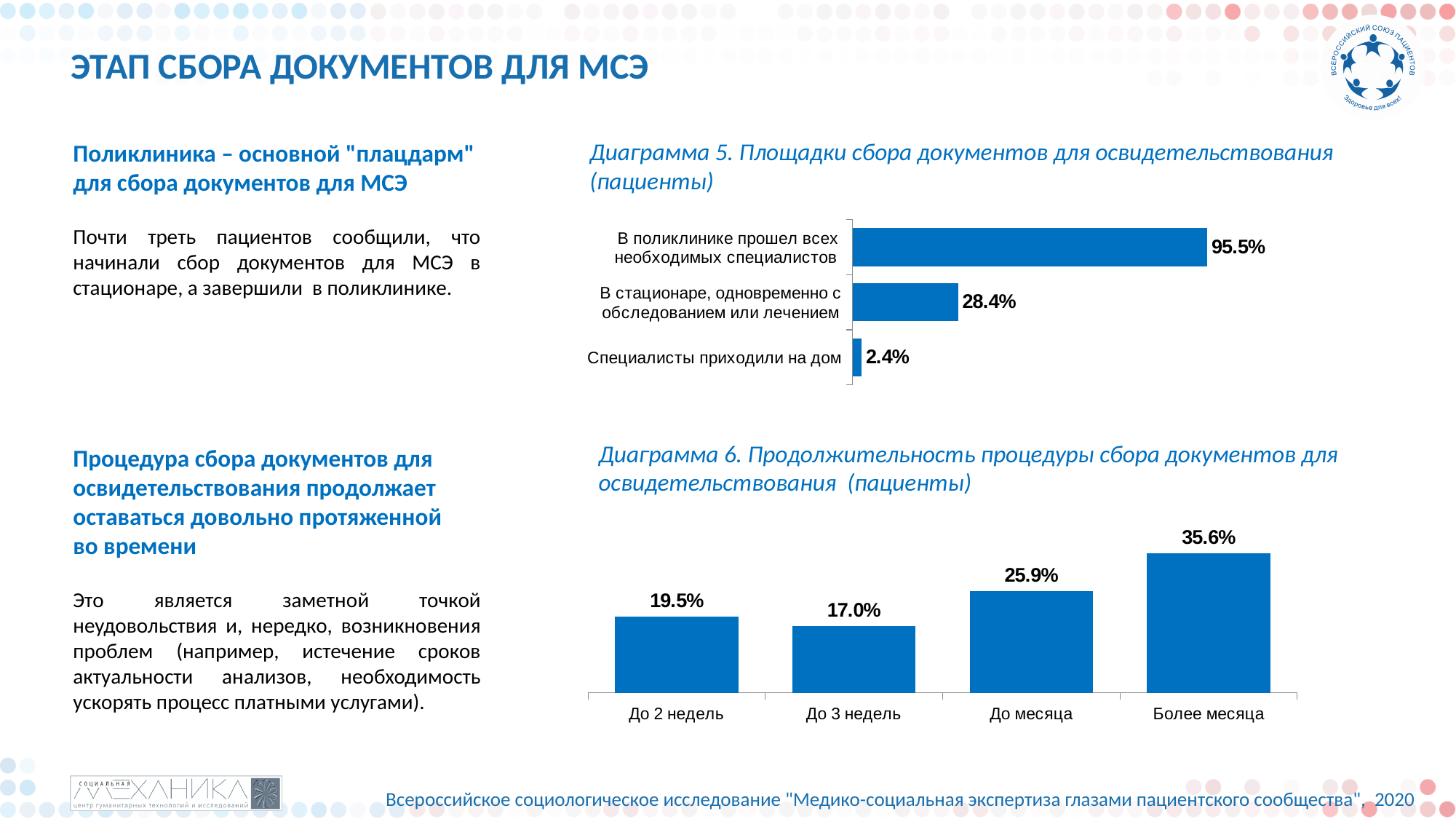
In Диаграмма 5, what is the difference between 'В поликлинике прошел всех необходимых специалистов' and 'В стационаре, одновременно с обследованием или лечением'? 67.1% In Диаграмма 6, which is larger: 'До 2 недель' or 'До месяца'? До месяца In Диаграмма 6, which category has the lowest value? До 3 недель In Диаграмма 5, what percentage of patients went through all necessary specialists in the polyclinic (В поликлинике прошел всех необходимых специалистов)? 95.5% In Диаграмма 6, how many categories are shown on the x axis? 4 In Диаграмма 5, how many categories are shown? 3 In Диаграмма 6, what is the value for 'До 3 недель'? 17.0% In Диаграмма 6, what is the difference between 'Более месяца' and 'До месяца'? 9.7% In Диаграмма 6, which category has the highest value? Более месяца What type of chart is Диаграмма 5? Bar chart In Диаграмма 5, which category has the lowest value? Специалисты приходили на дом In Диаграмма 5, what is the value for 'Специалисты приходили на дом'? 2.4%